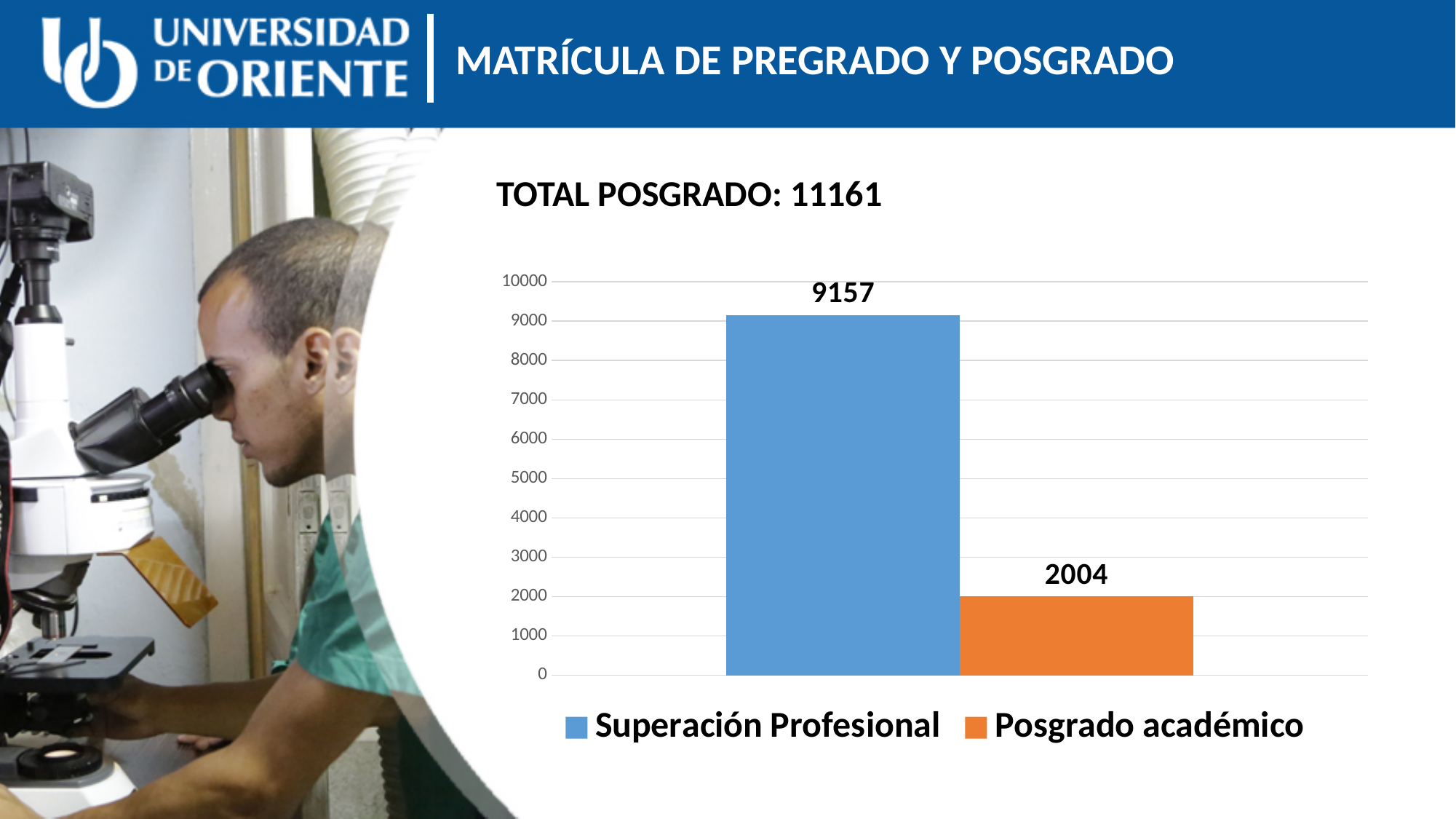
Is the value for Posgrado académico greater or less than 3000? less What kind of chart is shown on the slide? bar chart Which series has the lowest value? Posgrado académico What is the value for Posgrado académico? 2004 Which series has the highest value? Superación Profesional Which is larger, Superación Profesional or Posgrado académico? Superación Profesional Is the value for Superación Profesional greater or less than 9000? greater How many series does the legend list? 2 What is the value for Superación Profesional? 9157 How many bars are plotted in the chart? 2 What is the difference between the values for Superación Profesional and Posgrado académico? 7153 What colour is the bar for Posgrado académico? orange